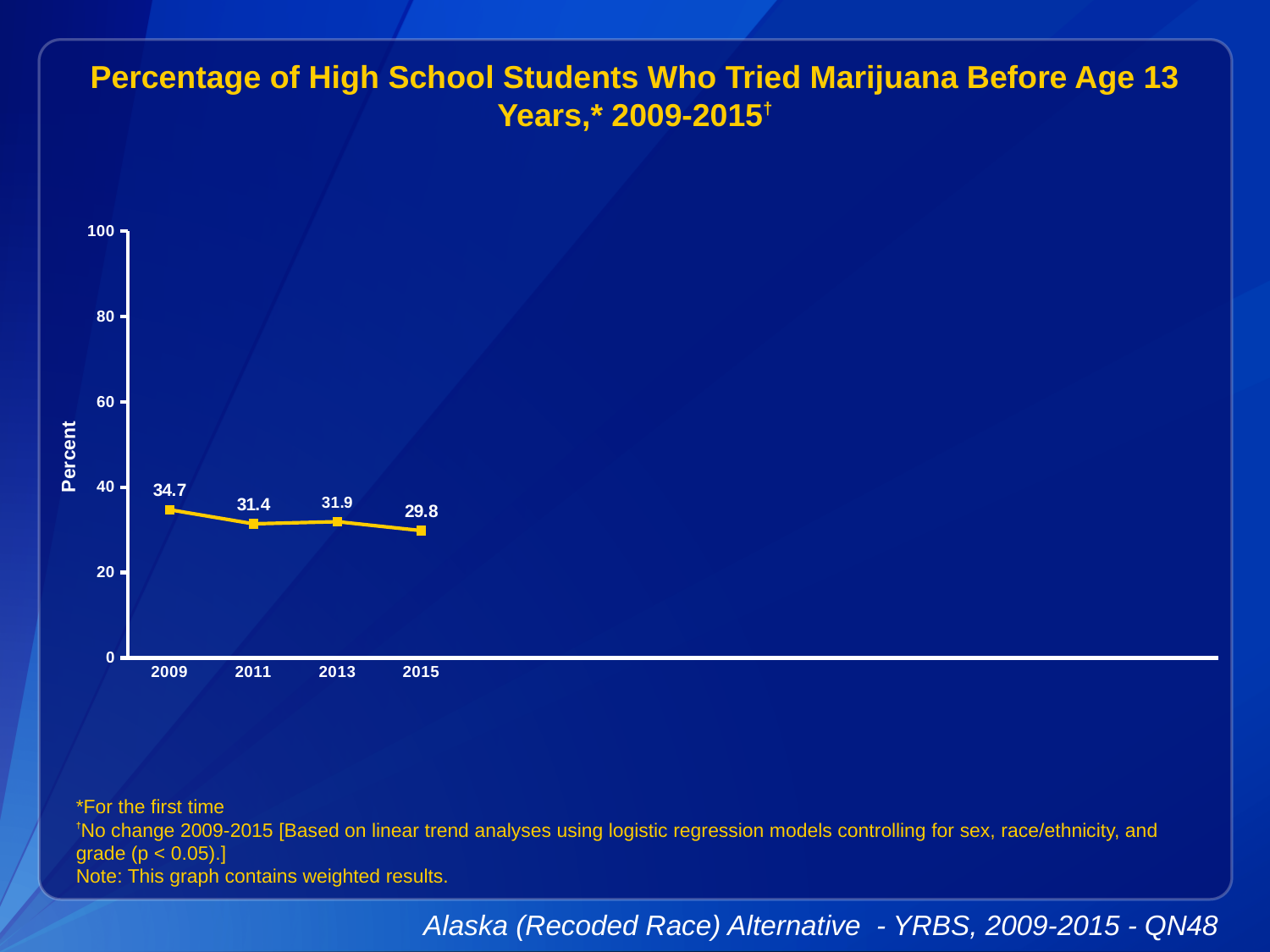
Do the values generally rise or fall from 2009 to 2015? fall What is the label on the vertical axis? Percent Which is larger, the value for 2011 or the value for 2013? 2013 What is the difference between the values for 2009 and 2015? 4.9 Which year has the lowest value? 2015 What kind of chart is shown? line chart Which year has the highest value? 2009 What is the value for 2013? 31.9 What is the value for 2015? 29.8 What is the value for 2009? 34.7 How many years are plotted on the chart? 4 Is the value for 2009 greater or less than 40? less